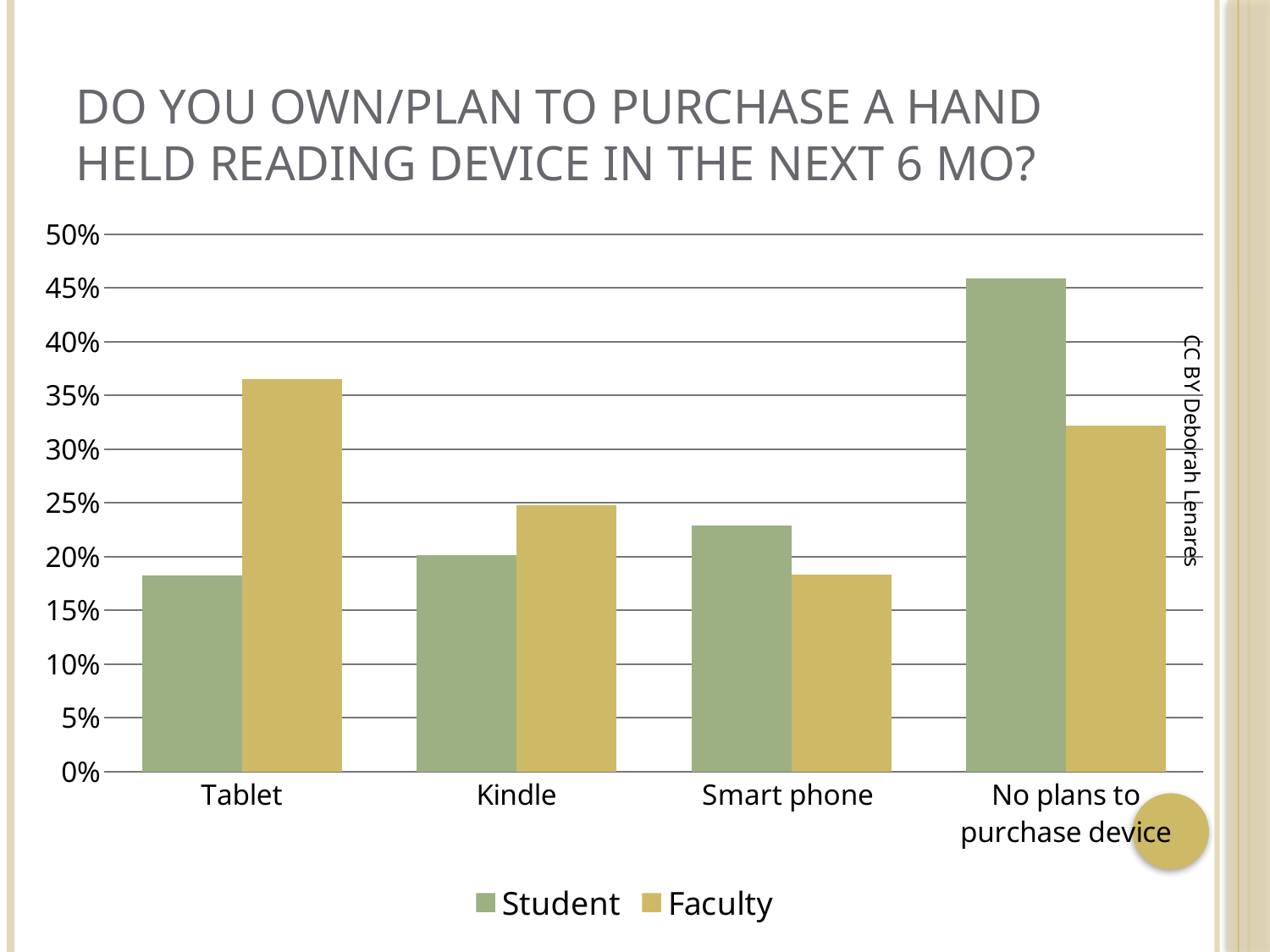
Which category has the lowest Faculty value? Smart phone What are the two series named in the chart's legend? Student and Faculty For Smart phone, which is larger, the Student value or the Faculty value? Student Is the Faculty value for Tablet greater or less than 30%? greater Is the Student value for Tablet greater or less than 20%? less Which category has the highest Faculty value? Tablet How many series does the chart's legend list? 2 Which category has the highest Student value? No plans to purchase device For Tablet, which is larger, the Student value or the Faculty value? Faculty How many categories are shown on the x axis of the chart? 4 Is the Student value for No plans to purchase device greater or less than 40%? greater What kind of chart is shown on the slide? bar chart